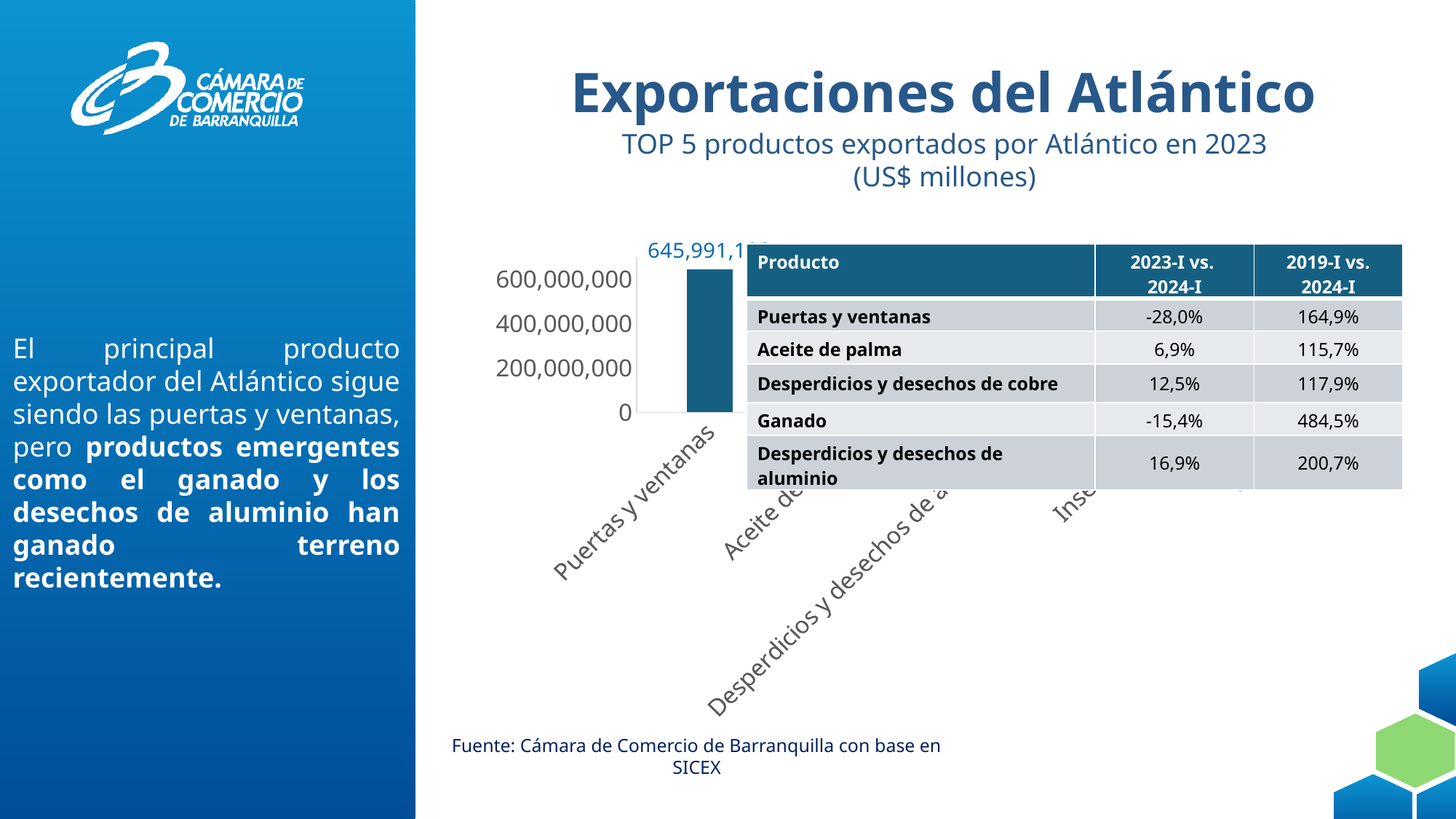
What is the highest tick label shown on the chart's vertical axis? 600,000,000 Is the value for Puertas y ventanas greater or less than 400,000,000? greater What is the subtitle of the chart on the slide? TOP 5 productos exportados por Atlántico en 2023 (US$ millones) Is the value for Puertas y ventanas greater or less than 600,000,000? greater What kind of chart is shown on the slide? bar chart